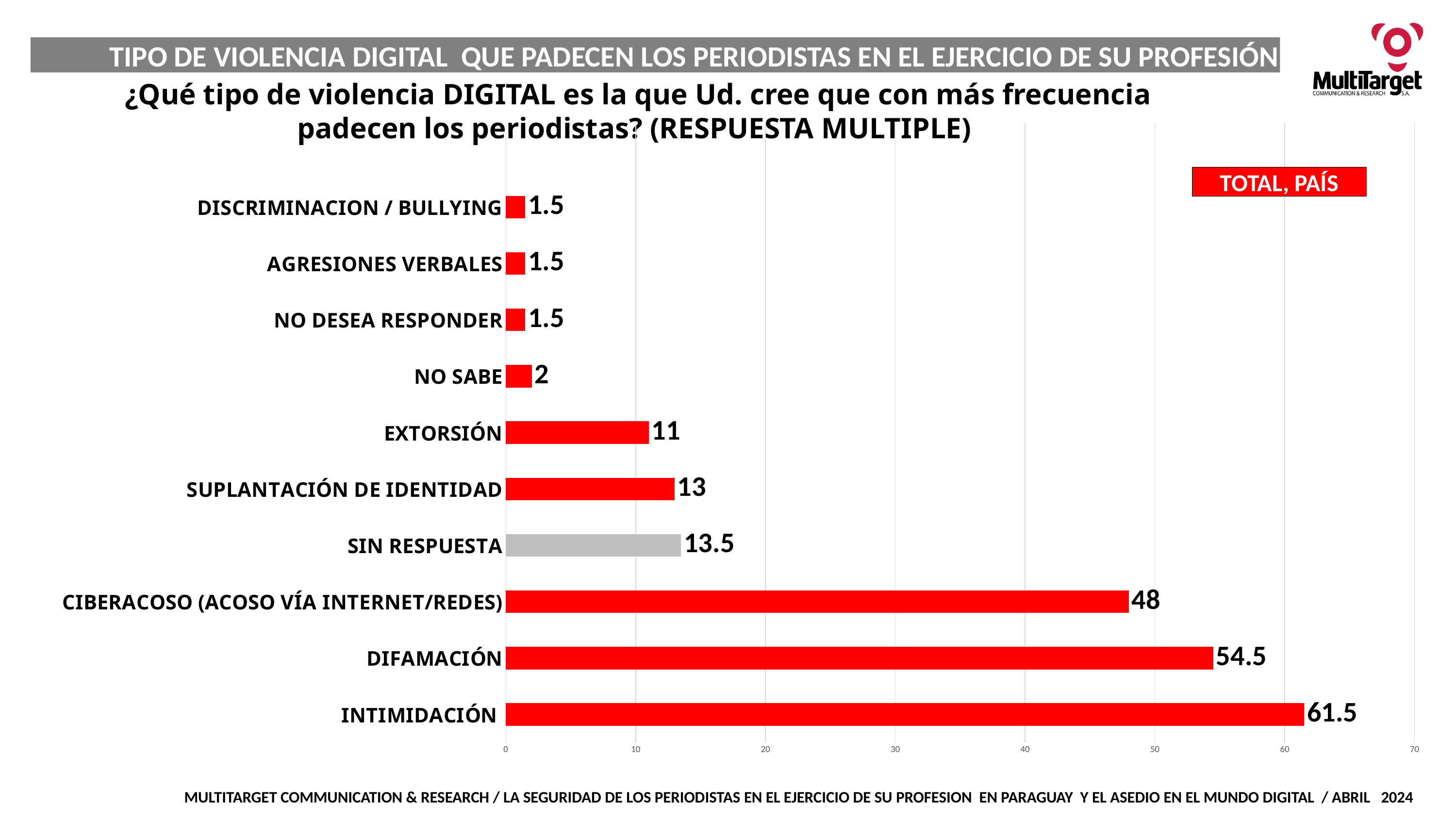
Which category has the highest value? INTIMIDACIÓN Which category's bar is coloured grey instead of red? SIN RESPUESTA How many categories are shown in the chart? 10 Is the value for CIBERACOSO (ACOSO VÍA INTERNET/REDES) greater or less than 40? greater What is the value for CIBERACOSO (ACOSO VÍA INTERNET/REDES)? 48 What is the value for INTIMIDACIÓN? 61.5 What is the value for SIN RESPUESTA? 13.5 What is the difference between the values for DIFAMACIÓN and CIBERACOSO (ACOSO VÍA INTERNET/REDES)? 6.5 What is the value for EXTORSIÓN? 11 What kind of chart is shown on the slide? bar chart Which is larger, the value for SUPLANTACIÓN DE IDENTIDAD or the value for EXTORSIÓN? SUPLANTACIÓN DE IDENTIDAD What is the difference between the values for INTIMIDACIÓN and DIFAMACIÓN? 7